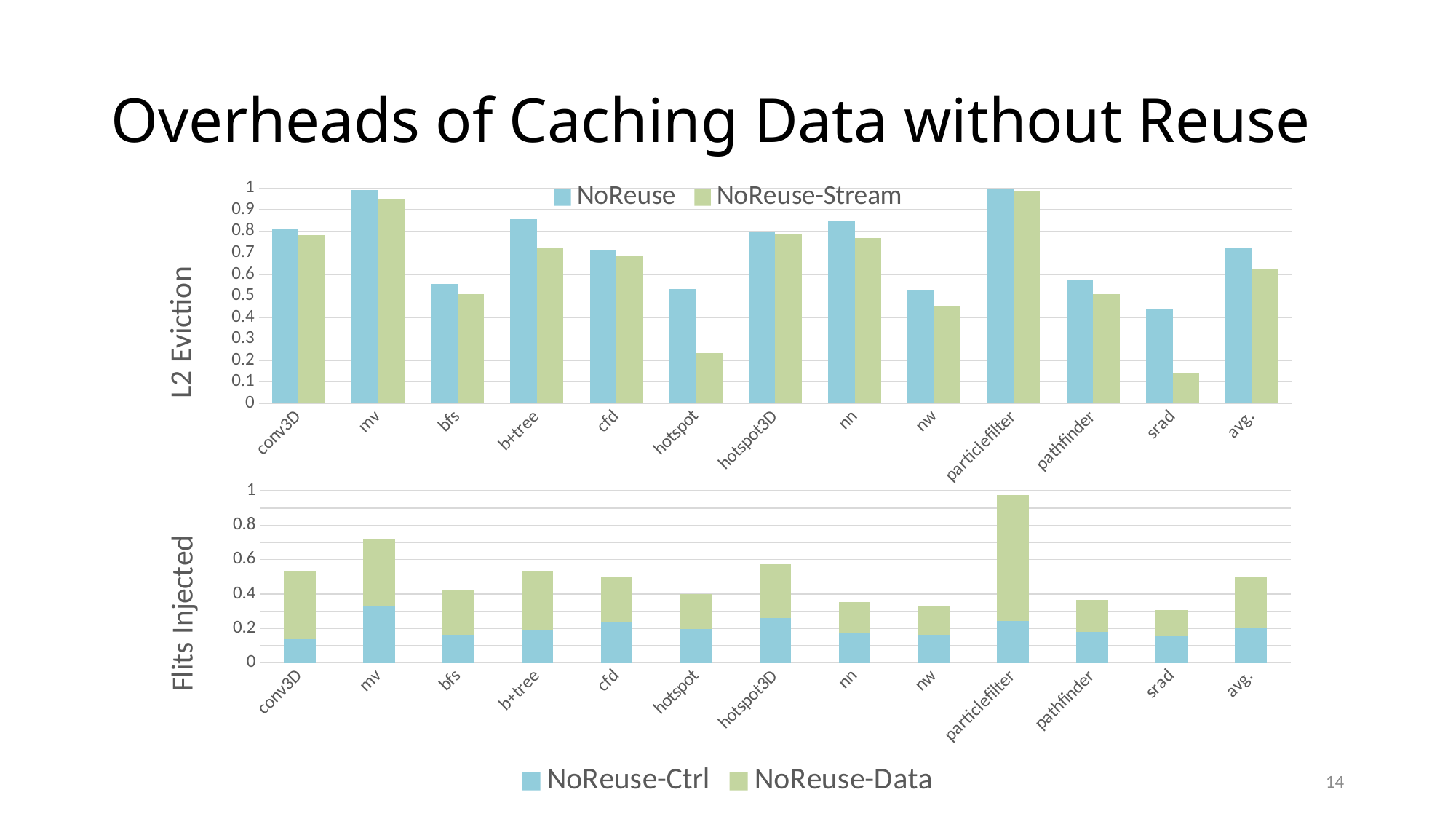
What kind of chart is the bottom chart (Flits Injected)? stacked bar chart In the bottom chart (Flits Injected), which category has the tallest stacked bar? particlefilter In the top chart (L2 Eviction), is the NoReuse-Stream value for hotspot greater or less than 0.3? less What kind of chart is the top chart (L2 Eviction)? bar chart In the top chart (L2 Eviction), which is larger for hotspot: the NoReuse value or the NoReuse-Stream value? NoReuse In the top chart (L2 Eviction), which category has the lowest NoReuse value? srad In the bottom chart (Flits Injected), is the total stacked value for particlefilter greater or less than 0.8? greater How many series does the legend of the top chart (L2 Eviction) list? 2 In the top chart (L2 Eviction), is the NoReuse value for b+tree greater or less than 0.8? greater In the top chart (L2 Eviction), which category has the lowest NoReuse-Stream value? srad In the bottom chart (Flits Injected), which category has the highest NoReuse-Ctrl value? mv How many categories are shown on the x axis of the top chart (L2 Eviction)? 13